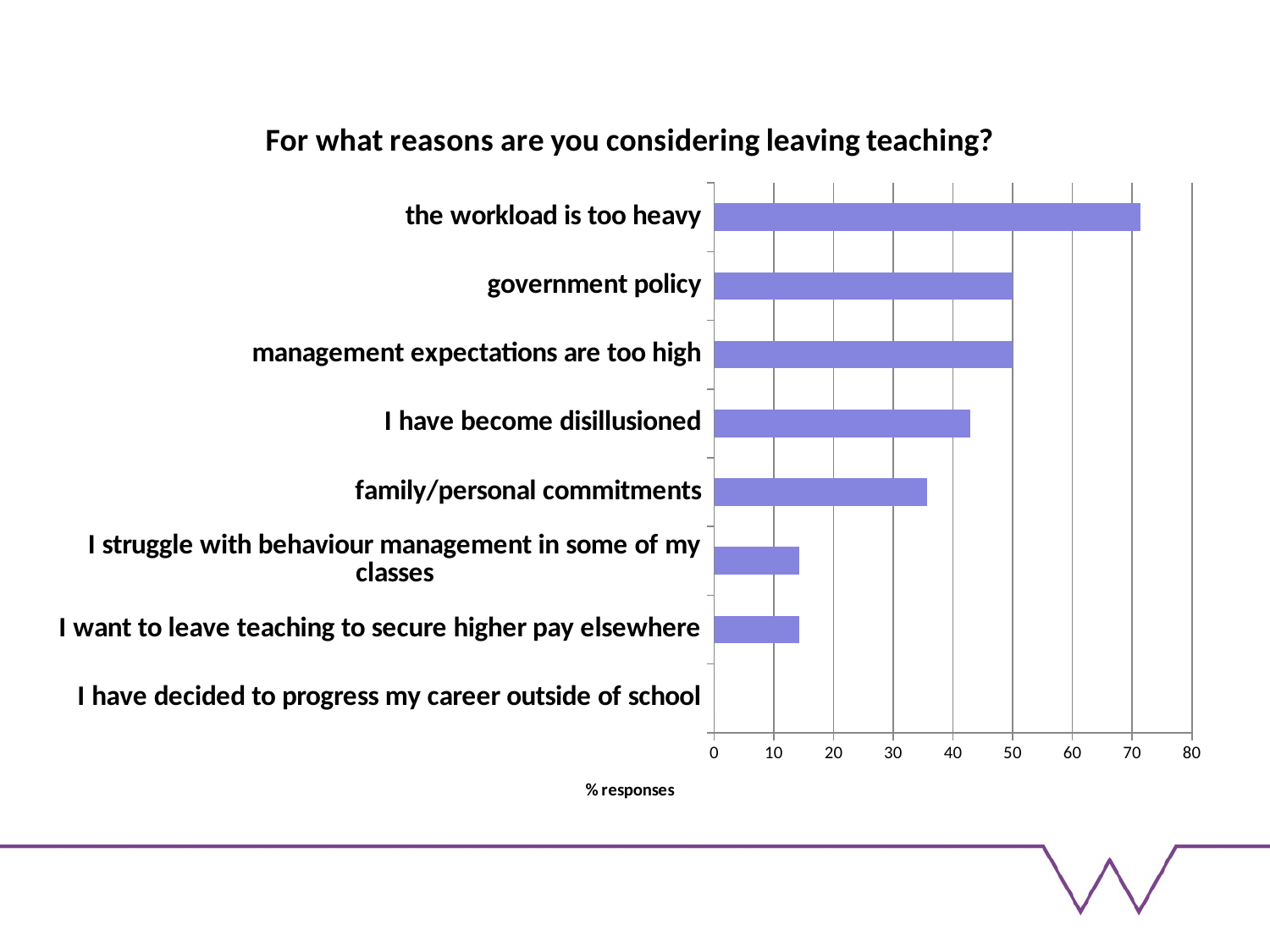
Is the value for 'the workload is too heavy' greater or less than 60? greater Which reason has the lowest percentage of responses? I have decided to progress my career outside of school Is the value for 'I have become disillusioned' greater or less than 40? greater Which reason has the highest percentage of responses? the workload is too heavy How many reasons (categories) are listed on the chart? 8 What is the label on the horizontal axis of the chart? % responses Is the value for 'I struggle with behaviour management in some of my classes' greater or less than 20? less Which has a higher percentage of responses: 'government policy' or 'I want to leave teaching to secure higher pay elsewhere'? government policy Which has a higher percentage of responses: 'I have become disillusioned' or 'family/personal commitments'? I have become disillusioned What is the title of the chart? For what reasons are you considering leaving teaching? What type of chart is shown on the slide? bar chart